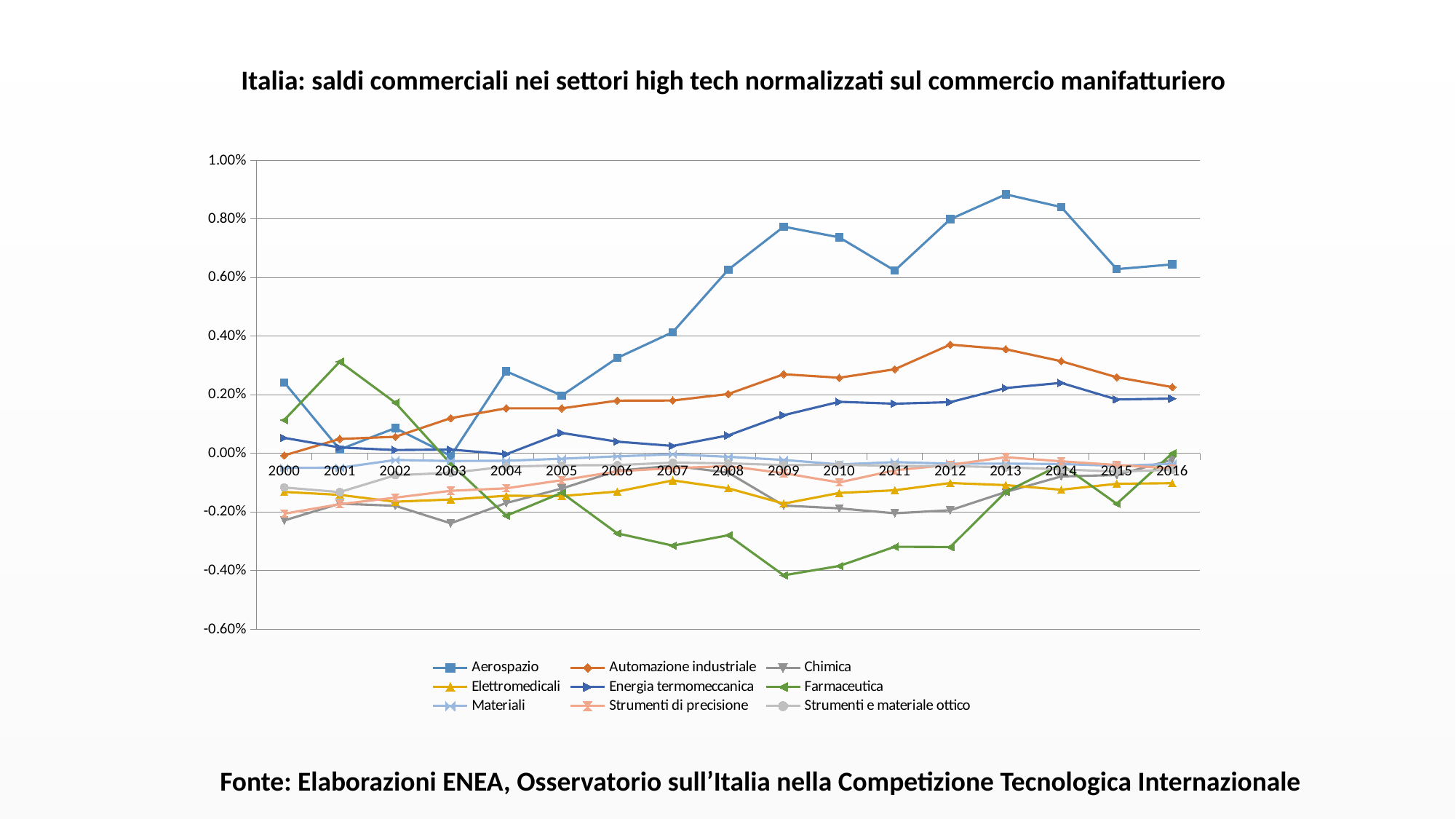
Is the value for Aerospazio in 2013 greater or less than 0.80%? greater What kind of chart is shown on the slide? line chart Which series has the highest value in 2013? Aerospazio How many series does the legend list? 9 Does the Aerospazio series rise or fall between 2005 and 2009? rise In which year does the Farmaceutica series reach its lowest value? 2009 In which year does the Aerospazio series reach its highest value? 2013 In 2012, which is larger: Automazione industriale or Energia termomeccanica? Automazione industriale How many years are plotted along the x axis? 17 Which series has the lowest value in 2009? Farmaceutica What is the title of the chart? Italia: saldi commerciali nei settori high tech normalizzati sul commercio manifatturiero